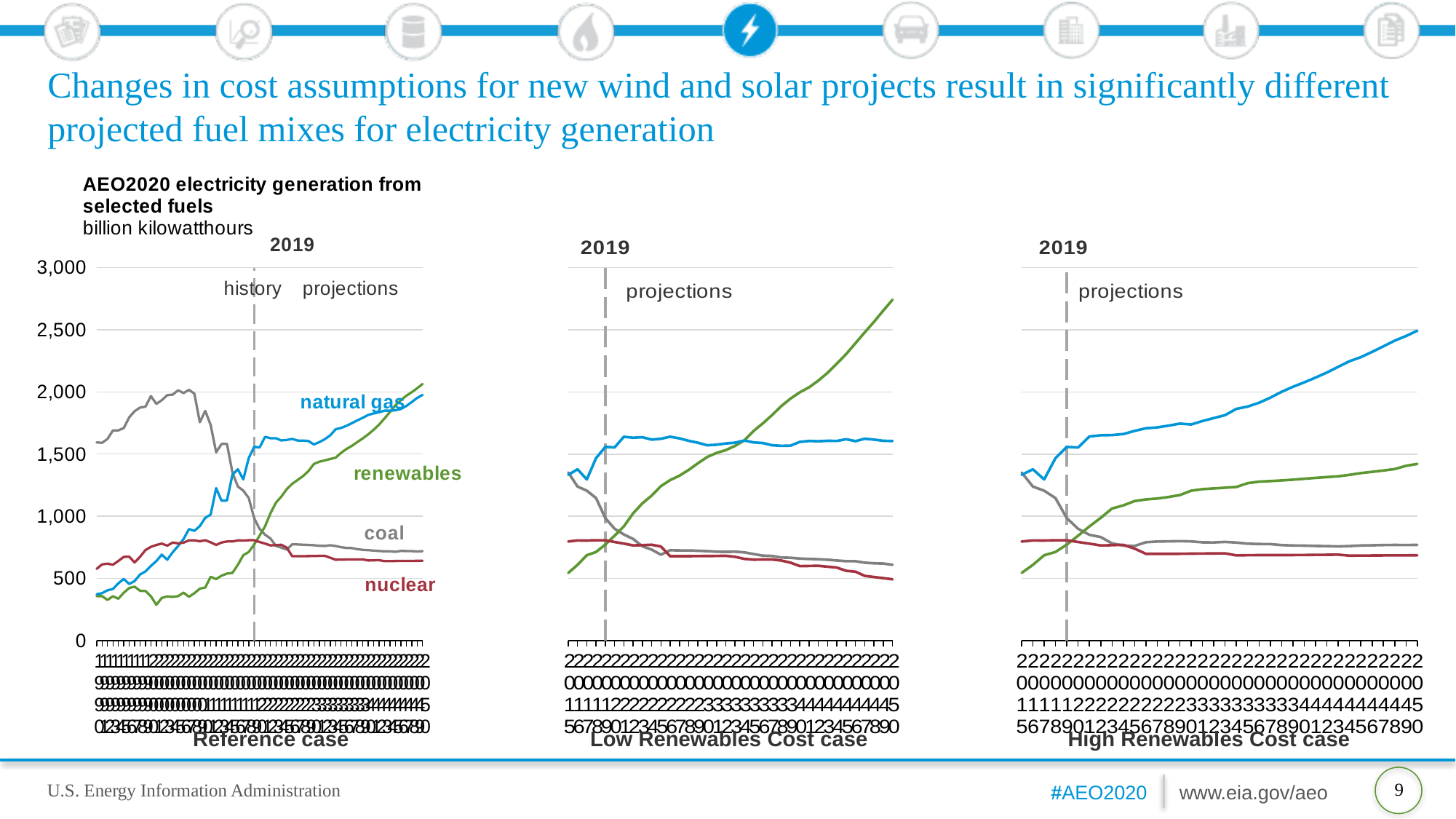
In the High Renewables Cost case chart, which is larger at the end of the projection period, natural gas or renewables? natural gas How many charts are shown on the slide? 3 In the Low Renewables Cost case chart, which is larger at the end of the projection period, renewables or natural gas? renewables How many fuel series are labelled on the Reference case chart? 4 What unit is used for the y axis of the charts? billion kilowatthours In the High Renewables Cost case chart, is the value for natural gas at the end of the projection period greater or less than 2,000? greater What kind of chart is the Reference case chart? line chart In the Reference case chart, is the value for coal at the end of the projection period greater or less than 1,000? less In the Reference case chart, which fuel has the lowest generation at the end of the projection period? nuclear In the High Renewables Cost case chart, does natural gas generation rise or fall over the projection period? rise In the Low Renewables Cost case chart, is the value for renewables at the end of the projection period greater or less than 2,500? greater What year does the dashed vertical line mark on each chart? 2019